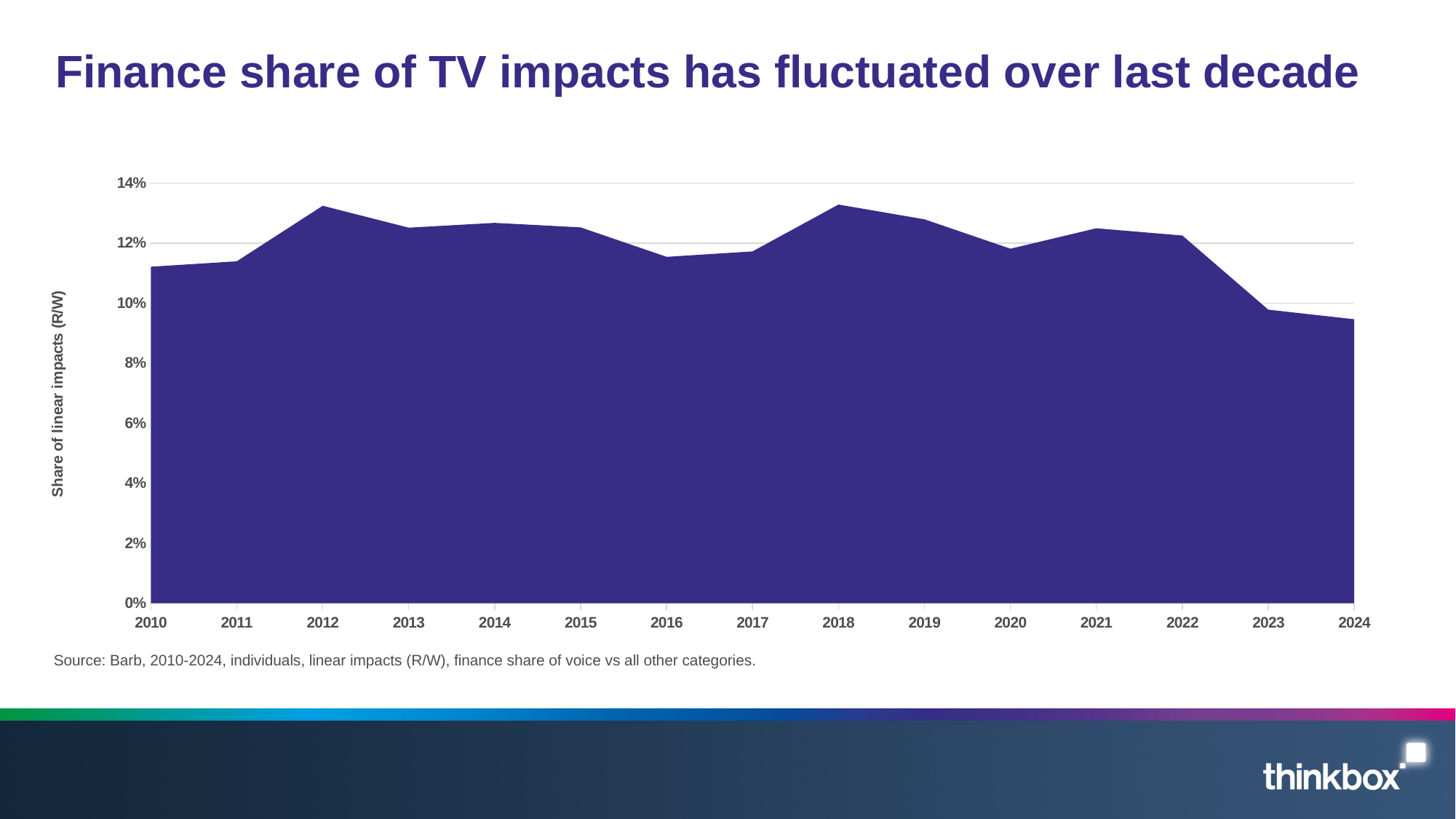
Is the value for 2016 greater or less than 12%? less Is the value for 2012 greater or less than 12%? greater Which year has the larger value, 2012 or 2024? 2012 Is the value for 2024 greater or less than 10%? less What is the title of the chart on the slide? Finance share of TV impacts has fluctuated over last decade What is the label on the vertical axis of the chart? Share of linear impacts (R/W) Do the values rise or fall from 2022 to 2024? fall Which year has the larger value, 2018 or 2023? 2018 How many years are plotted along the x axis of the chart? 15 What kind of chart is shown on the slide? Area chart